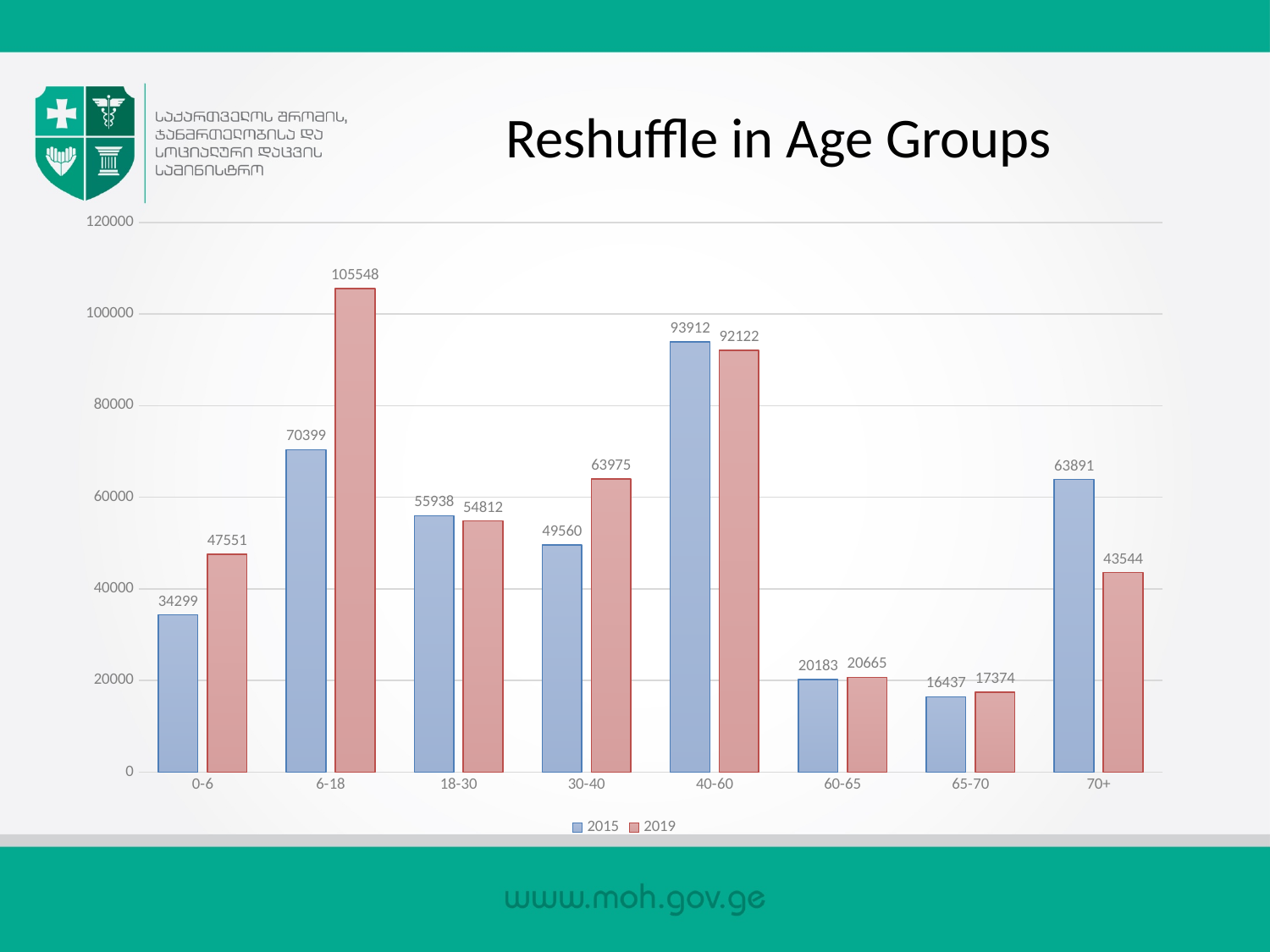
What is the value for the 6-18 age group in 2019? 105548 How many series does the legend list? 2 What is the value for the 70+ age group in 2015? 63891 What is the difference between the 2019 and 2015 values for the 6-18 age group? 35149 What kind of chart is shown on the slide? Bar chart What is the value for the 0-6 age group in 2015? 34299 How many age groups are shown on the x axis? 8 Which is larger for the 70+ age group, the 2015 value or the 2019 value? 2015 Which age group has the highest value in 2019? 6-18 Is the 2015 value for the 40-60 age group greater or less than 80000? greater What is the title of the chart? Reshuffle in Age Groups Which age group has the lowest value in 2015? 65-70